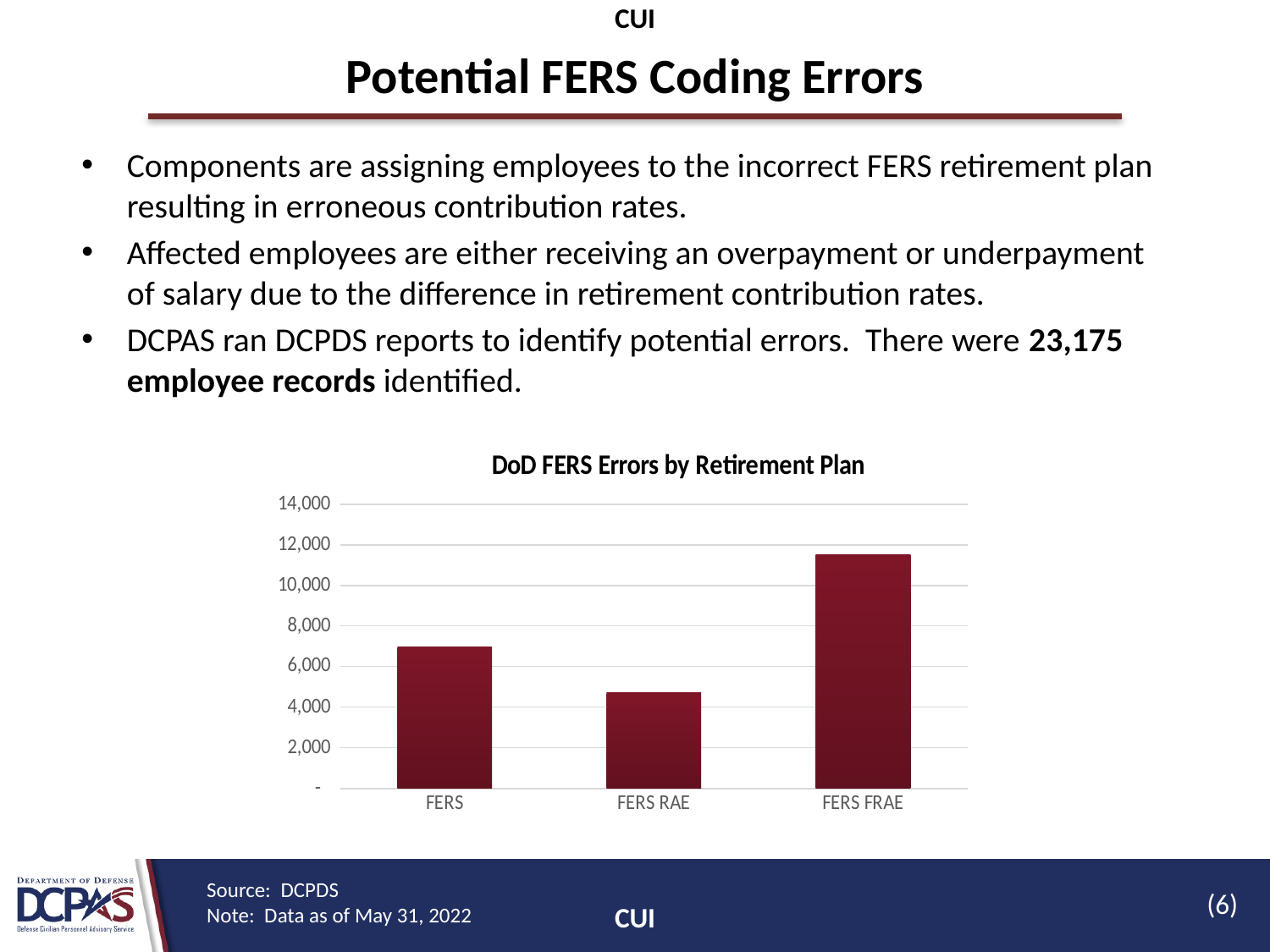
How many retirement plan categories are shown on the x axis of the chart? 3 What kind of chart is shown under the title "DoD FERS Errors by Retirement Plan"? bar chart Is the value for FERS FRAE greater or less than 10,000? greater What is the title of the chart on the slide? DoD FERS Errors by Retirement Plan Which retirement plan has the highest number of errors in the chart? FERS FRAE Which has more errors in the chart, FERS or FERS FRAE? FERS FRAE Is the value for FERS greater or less than 8,000? less What is the highest value labelled on the chart's vertical axis? 14,000 Is the value for FERS greater or less than 6,000? greater Which retirement plan has the lowest number of errors in the chart? FERS RAE Which has more errors in the chart, FERS or FERS RAE? FERS